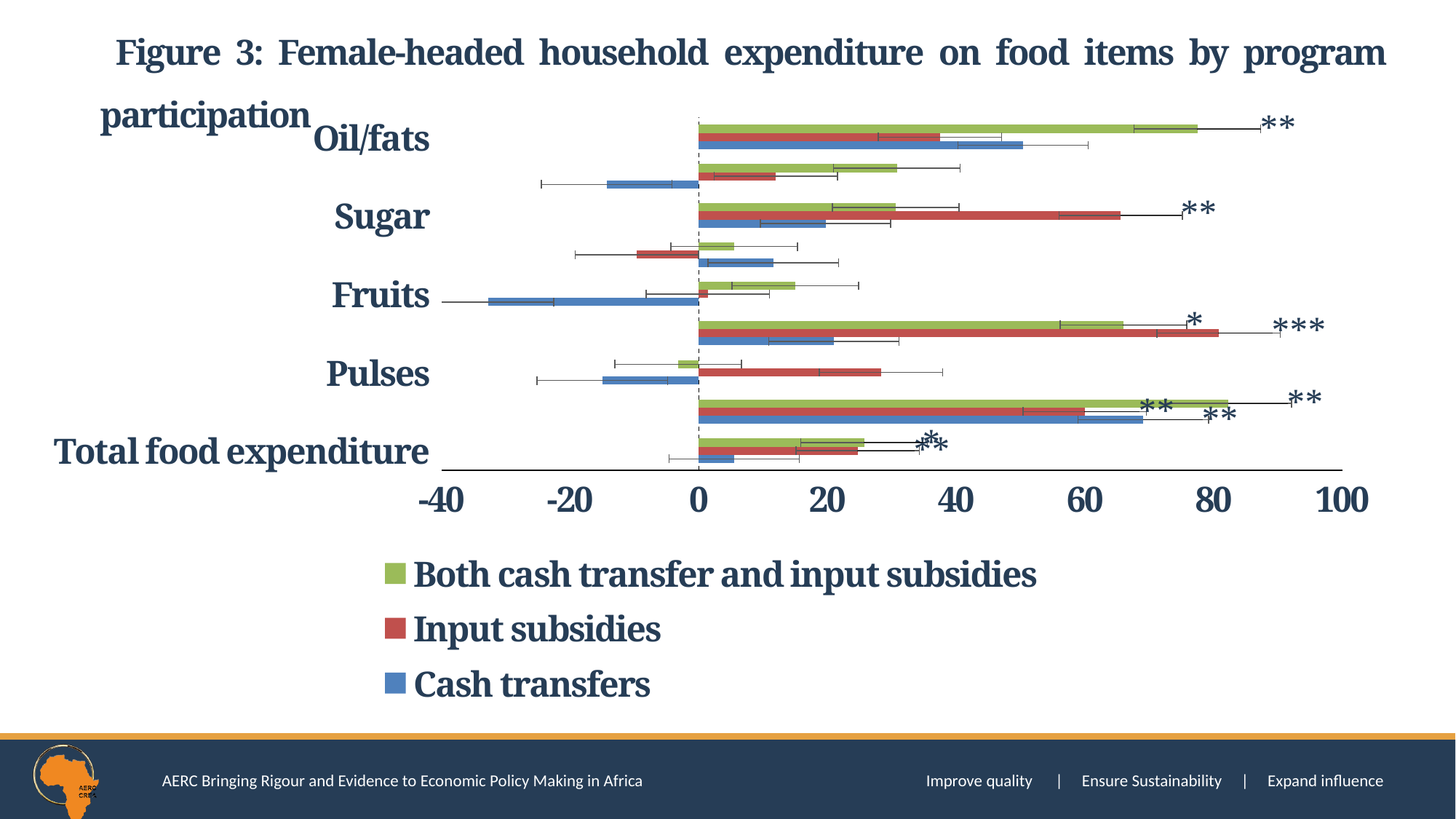
Is the value for Sugar under Input subsidies greater or less than 40? greater For Oil/fats, which series has the highest value? Both cash transfer and input subsidies What kind of chart is shown on the slide? Bar chart For Oil/fats, which is larger: Both cash transfer and input subsidies or Input subsidies? Both cash transfer and input subsidies Which series does the green colour represent in the legend? Both cash transfer and input subsidies Is the value for Total food expenditure under Cash transfers greater or less than 20? less Is the value for Oil/fats under Both cash transfer and input subsidies greater or less than 60? greater For Pulses, which is larger: Input subsidies or Cash transfers? Input subsidies How many series does the legend list? 3 For Sugar, which is larger: Input subsidies or Cash transfers? Input subsidies For Sugar, which series has the lowest value? Cash transfers